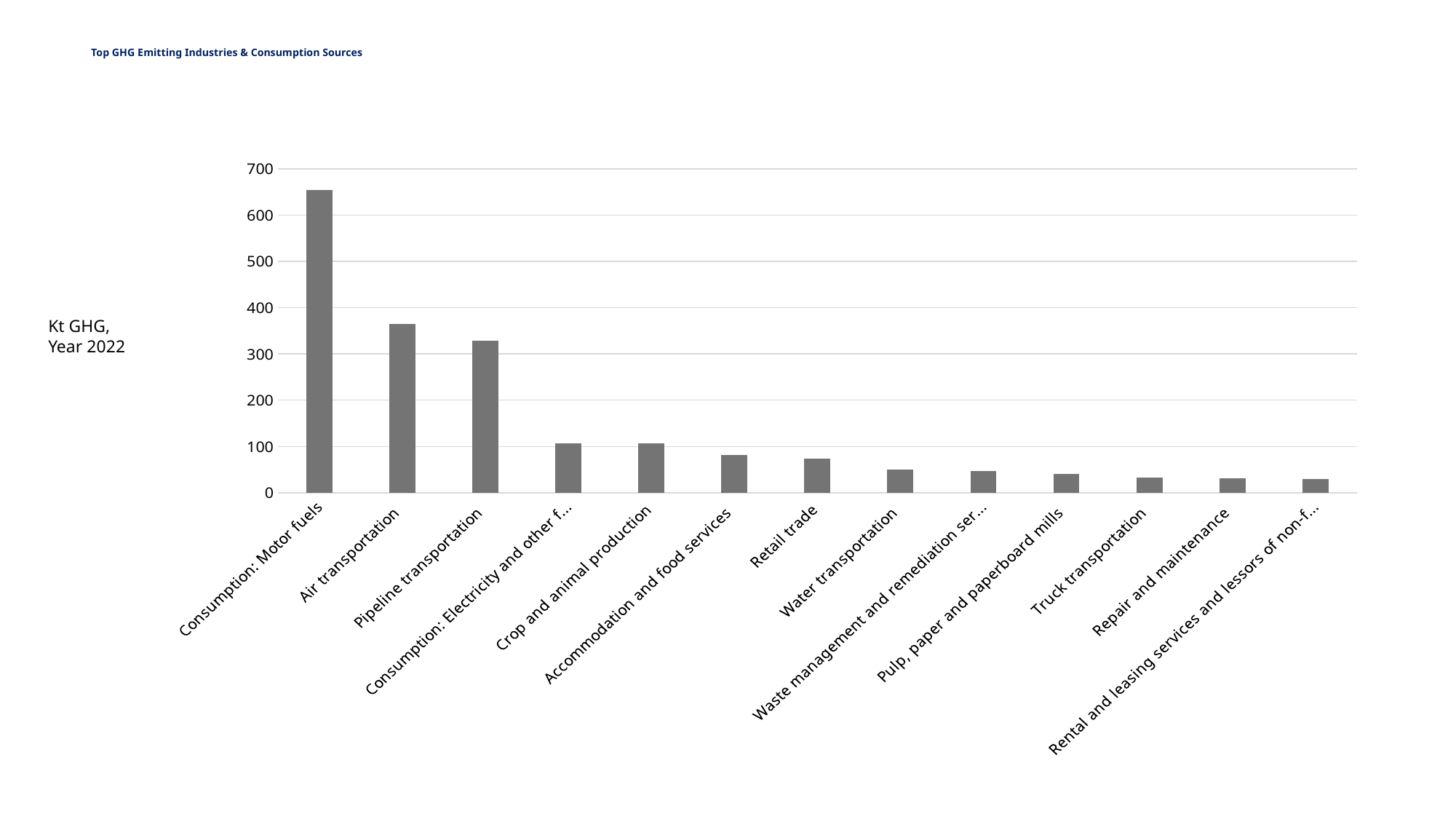
Is the value for Retail trade greater or less than 100? less What is the title of the chart? Top GHG Emitting Industries & Consumption Sources Which category has the highest value? Consumption: Motor fuels Is the value for Water transportation greater or less than 100? less Is the value for Air transportation greater or less than 400? less Which is larger, the value for Retail trade or the value for Water transportation? Retail trade Do the values rise or fall moving from left to right along the x axis? fall What kind of chart is shown on the slide? bar chart Which is larger, the value for Air transportation or the value for Pipeline transportation? Air transportation How many categories are plotted on the chart? 13